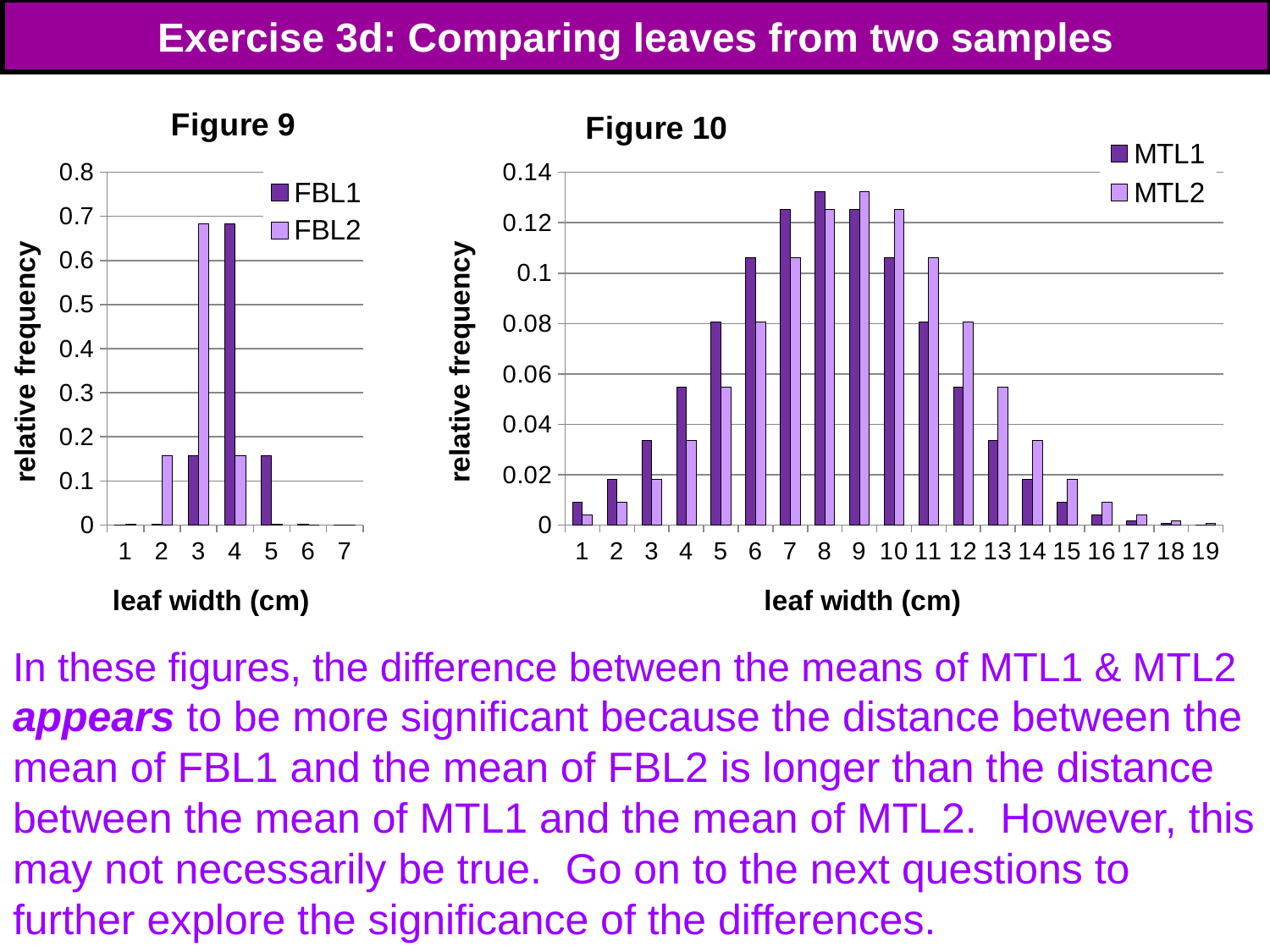
What is the y-axis label of Figure 10? relative frequency In Figure 9, is the FBL1 value at leaf width 4 greater or less than 0.6? greater In Figure 9, how many series does the legend list? 2 In Figure 9, how many leaf width categories are shown on the x axis? 7 In Figure 10, at leaf width 4, which series has the larger value, MTL1 or MTL2? MTL1 In Figure 10, at which leaf width is the MTL1 relative frequency highest? 8 In Figure 9, is the FBL2 value at leaf width 2 greater or less than 0.3? less What kind of chart is Figure 9? bar chart In Figure 10, how many series does the legend list? 2 In Figure 9, at which leaf width is the FBL1 relative frequency highest? 4 In Figure 10, how many leaf width categories are shown on the x axis? 19 In Figure 9, at which leaf width is the FBL2 relative frequency highest? 3